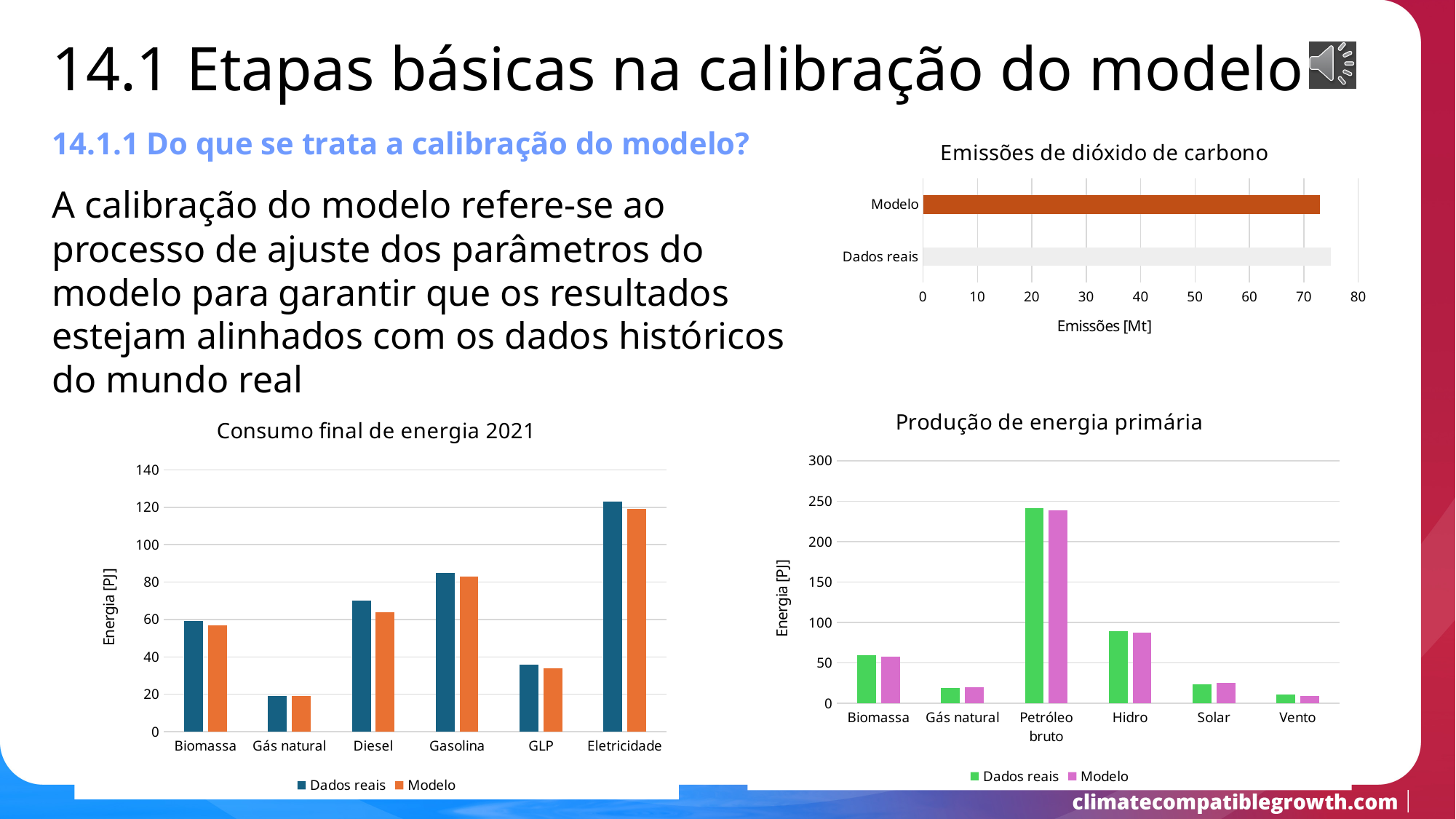
In the chart titled 'Consumo final de energia 2021', which is larger for Dados reais: Diesel or Gasolina? Gasolina In the chart titled 'Consumo final de energia 2021', which category has the lowest value for Modelo? Gás natural In the chart titled 'Produção de energia primária', which category has the highest value? Petróleo bruto In the chart titled 'Emissões de dióxido de carbono', is the value for Modelo greater or less than 60? greater In the chart titled 'Consumo final de energia 2021', is the Modelo value for GLP greater or less than 40? less In the chart titled 'Produção de energia primária', is the Dados reais value for Petróleo bruto greater or less than 200? greater In the chart titled 'Consumo final de energia 2021', how many categories are shown on the x axis? 6 In the chart titled 'Consumo final de energia 2021', which category has the highest value for Dados reais? Eletricidade In the chart titled 'Produção de energia primária', which category has the lowest value for Dados reais? Vento In the chart titled 'Produção de energia primária', how many series does the legend list? 2 What kind of chart is the one titled 'Emissões de dióxido de carbono'? bar chart